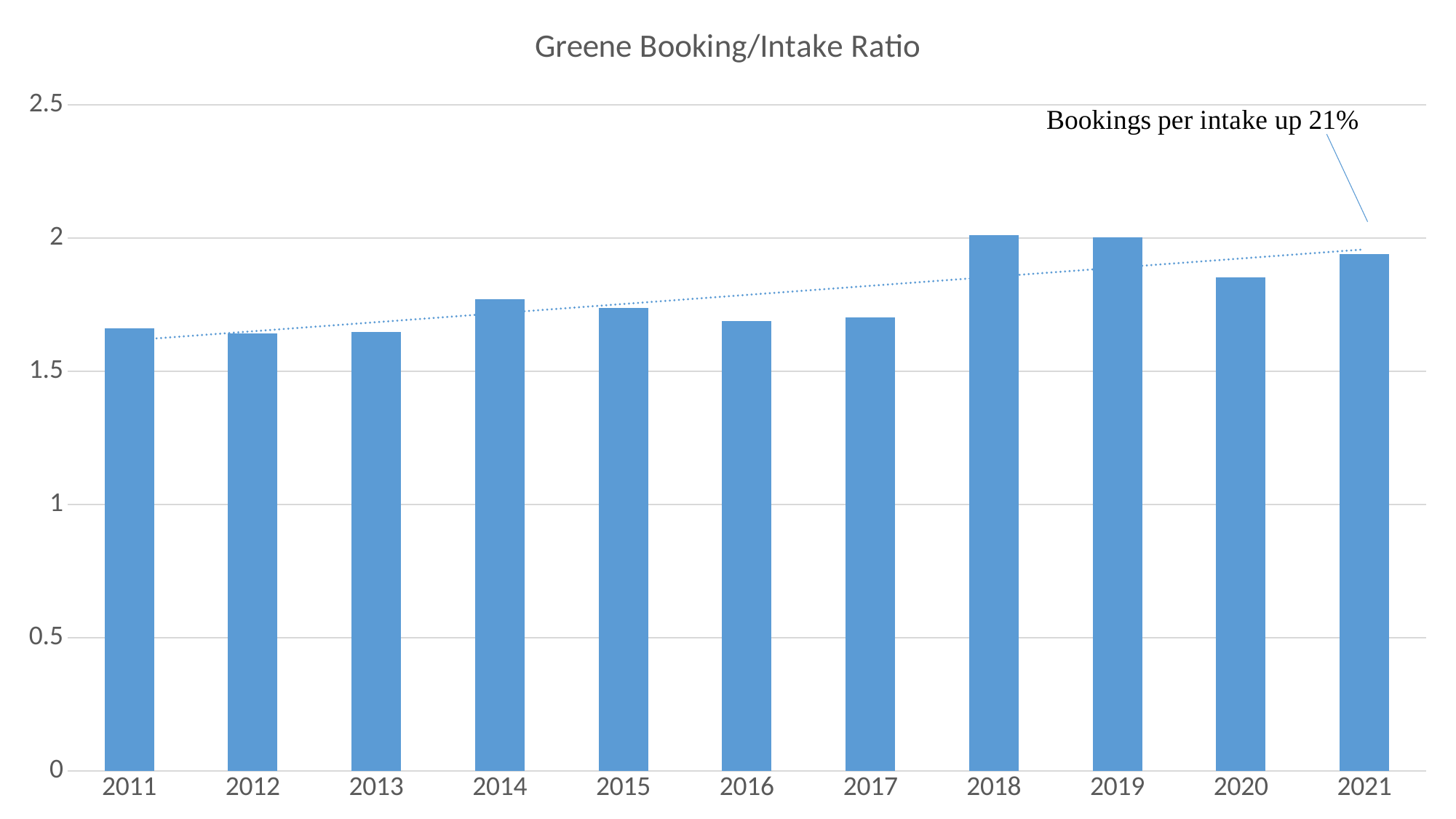
Is the value for 2014 greater or less than 2? less How many years are shown on the x axis of the chart? 11 Which is larger, the value for 2013 or the value for 2019? 2019 Which is larger, the value for 2018 or the value for 2011? 2018 Do the values generally rise or fall from 2011 to 2021? rise Is the value for 2016 greater or less than 1? greater Is the value for 2020 greater or less than 2? less What kind of chart is shown on the slide? bar chart What is the title of the chart? Greene Booking/Intake Ratio What does the annotation text on the chart say? Bookings per intake up 21%